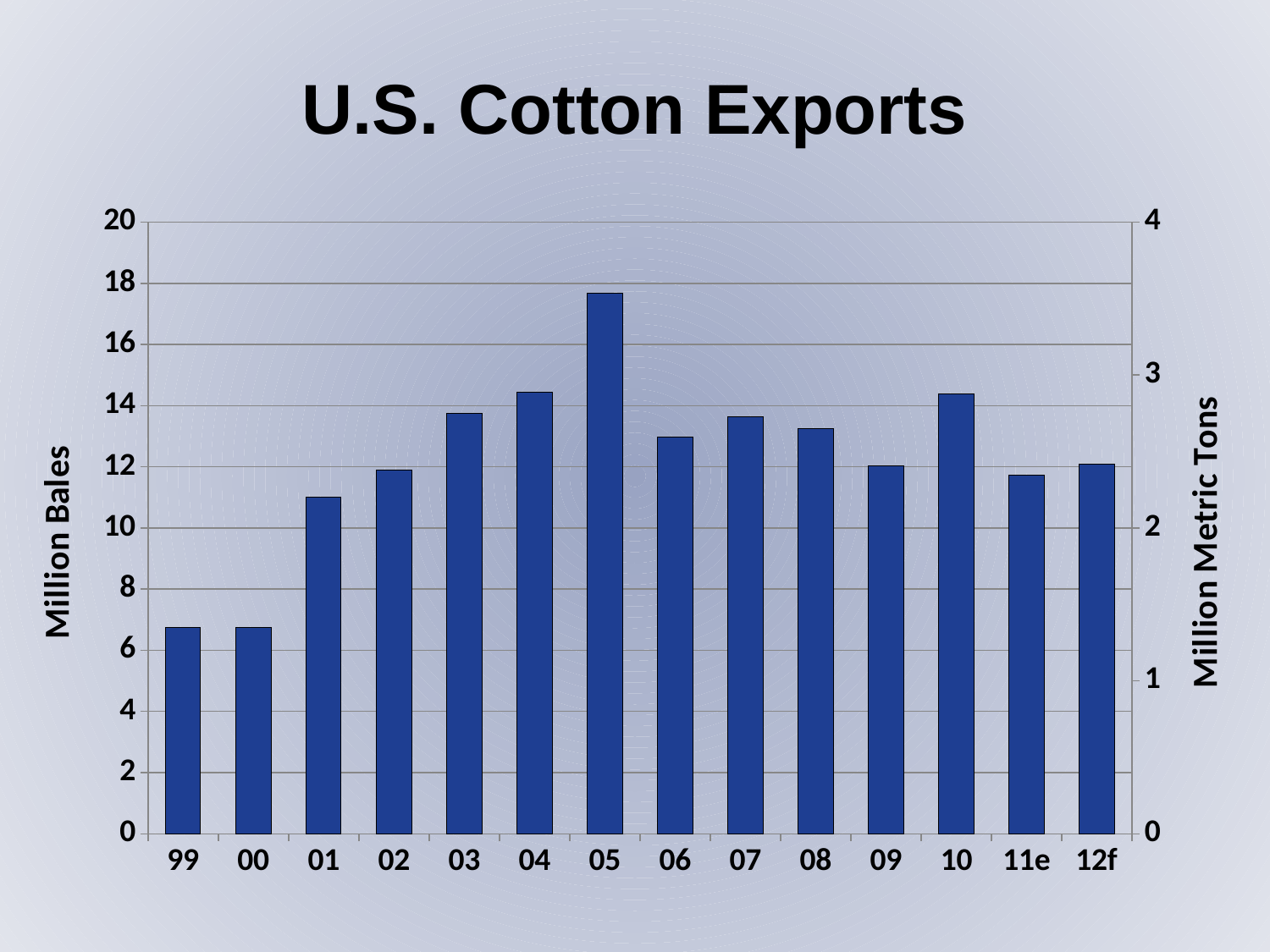
Is the value for 99 greater or less than 8 million bales? less Which is larger, the value for 05 or the value for 06? 05 What kind of chart is shown on the slide? bar chart Is the value for 05 greater or less than 16 million bales? greater Which year has the highest cotton exports? 05 What is the label of the right-hand vertical axis? Million Metric Tons Is the value for 01 greater or less than 10 million bales? greater Do the values rise or fall from 99 to 05? rise Which is larger, the value for 99 or the value for 01? 01 What is the title of the chart? U.S. Cotton Exports How many years (categories) are plotted on the x axis? 14